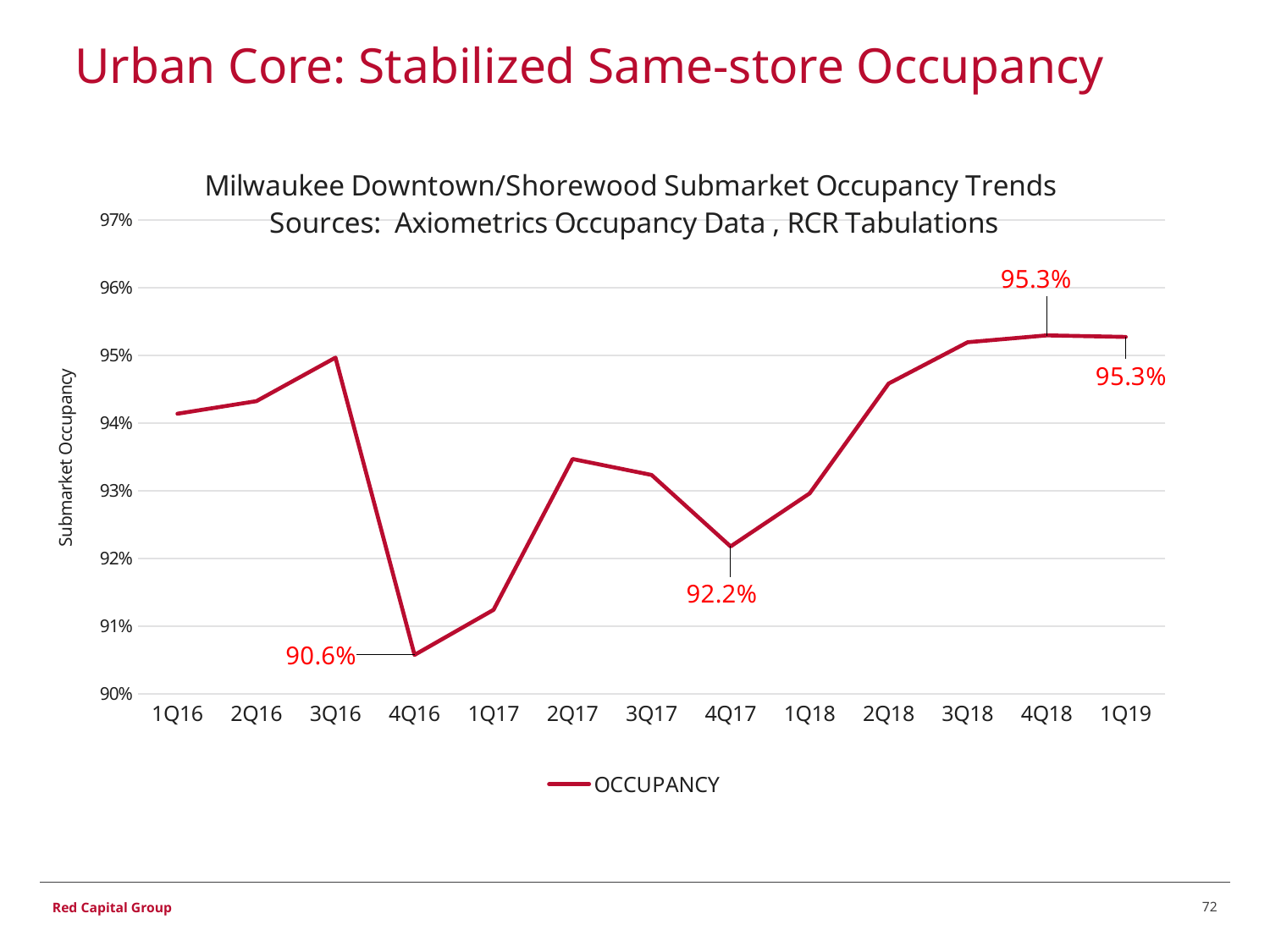
Which quarter has the higher occupancy, 4Q16 or 4Q17? 4Q17 What is the occupancy value shown for 1Q19? 95.3% What is the occupancy value shown for 4Q16? 90.6% Does occupancy rise or fall from 4Q17 to 4Q18? Rise Is the occupancy value for 1Q17 greater or less than 92%? less Is the occupancy value for 3Q16 greater or less than 94%? greater What is the occupancy value shown for 4Q18? 95.3% What is the occupancy value shown for 4Q17? 92.2% What is the difference between the occupancy in 4Q18 and in 4Q16? 4.7 percentage points Which quarter has the lowest occupancy on the chart? 4Q16 How many quarters are plotted on the x axis? 13 What kind of chart is shown on the slide? Line chart